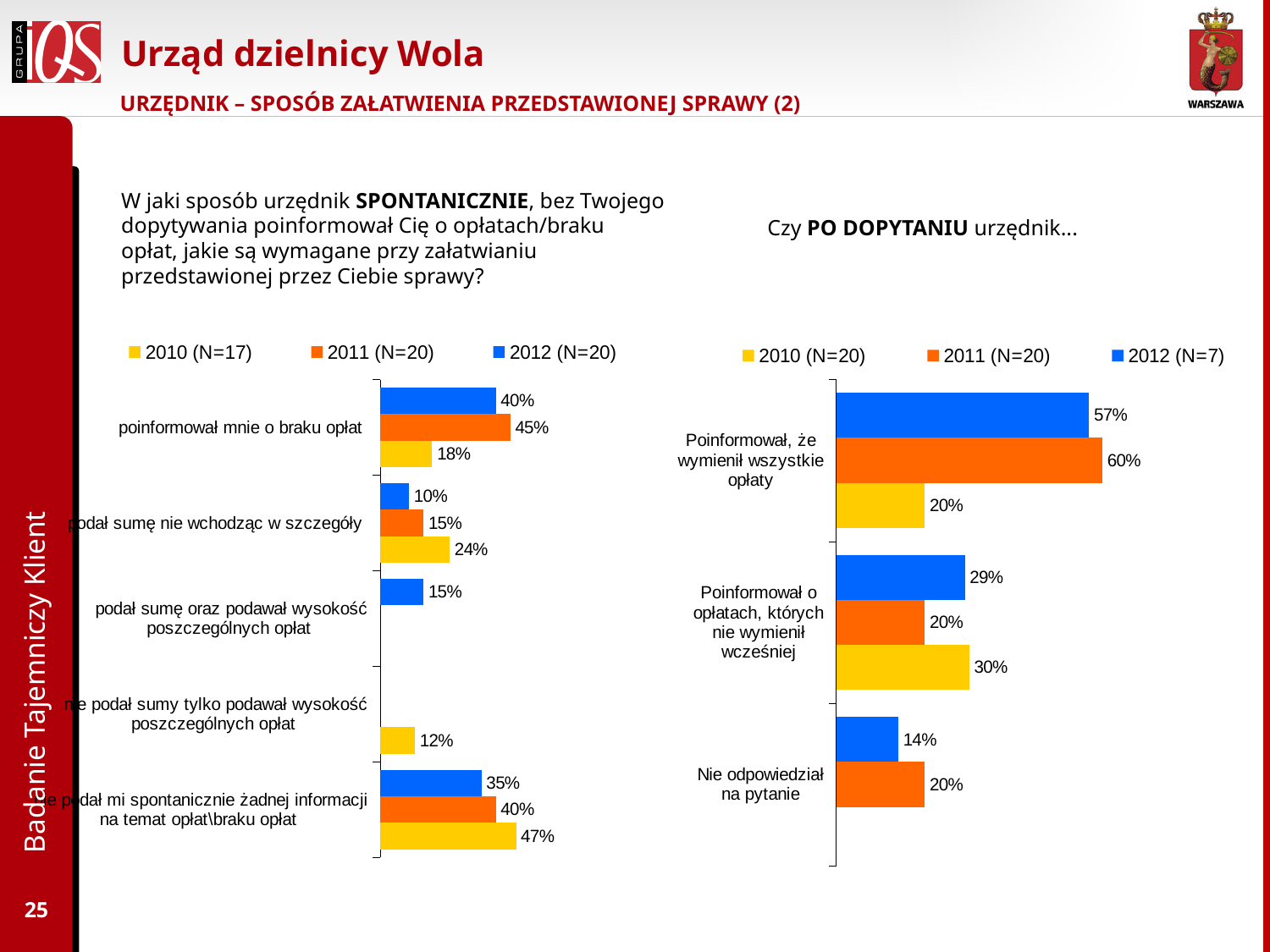
In the right chart, what is the 2011 value for "Poinformował, że wymienił wszystkie opłaty"? 60% In the left chart, what is the 2012 value for "podał sumę nie wchodząc w szczegóły"? 10% In the left chart, what is the 2010 value for "nie podał mi spontanicznie żadnej informacji na temat opłat\braku opłat"? 47% In the left chart, how many series does the legend list? 3 What type of chart is the right chart? Bar chart In the right chart, what is the difference between the 2012 and 2010 values for "Poinformował, że wymienił wszystkie opłaty"? 37 percentage points In the left chart, what is the 2011 value for "poinformował mnie o braku opłat"? 45% In the right chart, which is larger for "Poinformował o opłatach, których nie wymienił wcześniej": the 2010 value or the 2011 value? 2010 In the left chart, what is the difference between the 2011 and 2010 values for "poinformował mnie o braku opłat"? 27 percentage points In the right chart, how many categories are shown? 3 In the right chart, what is the 2012 value for "Nie odpowiedział na pytanie"? 14% In the left chart, which year has the highest value for "podał sumę nie wchodząc w szczegóły"? 2010